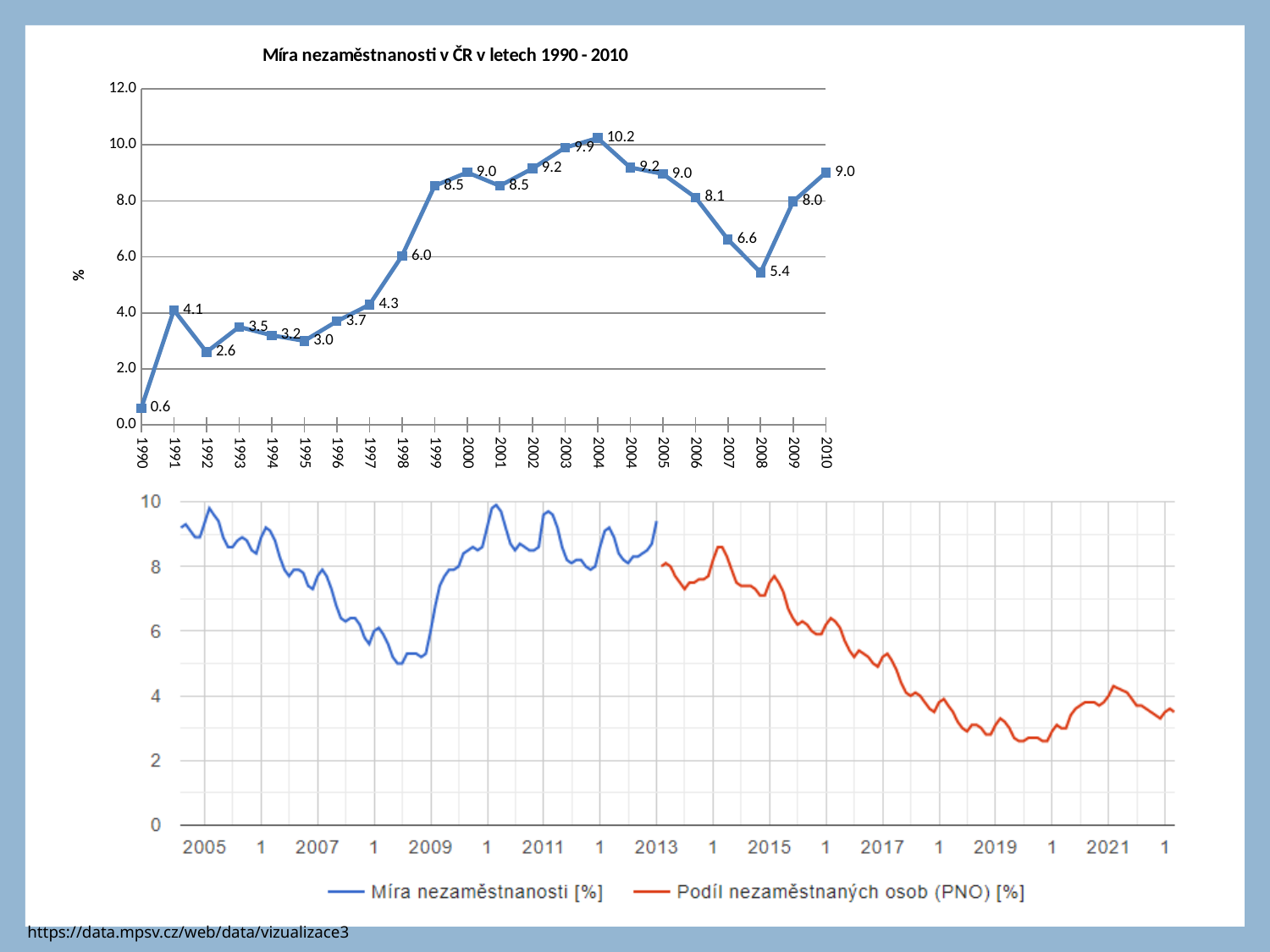
In the top chart, how many data points are plotted? 22 In the top chart, which year has the lowest unemployment rate? 1990 In the bottom chart, is the value of Podíl nezaměstnaných osob (PNO) at the start of 2019 greater or less than 4? less In the bottom chart, how many series does the legend list? 2 What type of chart is the top chart? Line chart In the top chart, what is the value for 2008? 5.4 In the top chart, what is the unemployment rate for 1990? 0.6 In the top chart, do the values rise or fall from 2005 to 2008? Fall In the top chart, which is larger, the value for 1991 or the value for 1992? 1991 In the top chart, what is the value for 1998? 6.0 In the top chart, what is the difference between the values for 2010 and 2008? 3.6 In the top chart, which year has the highest unemployment rate? 2004